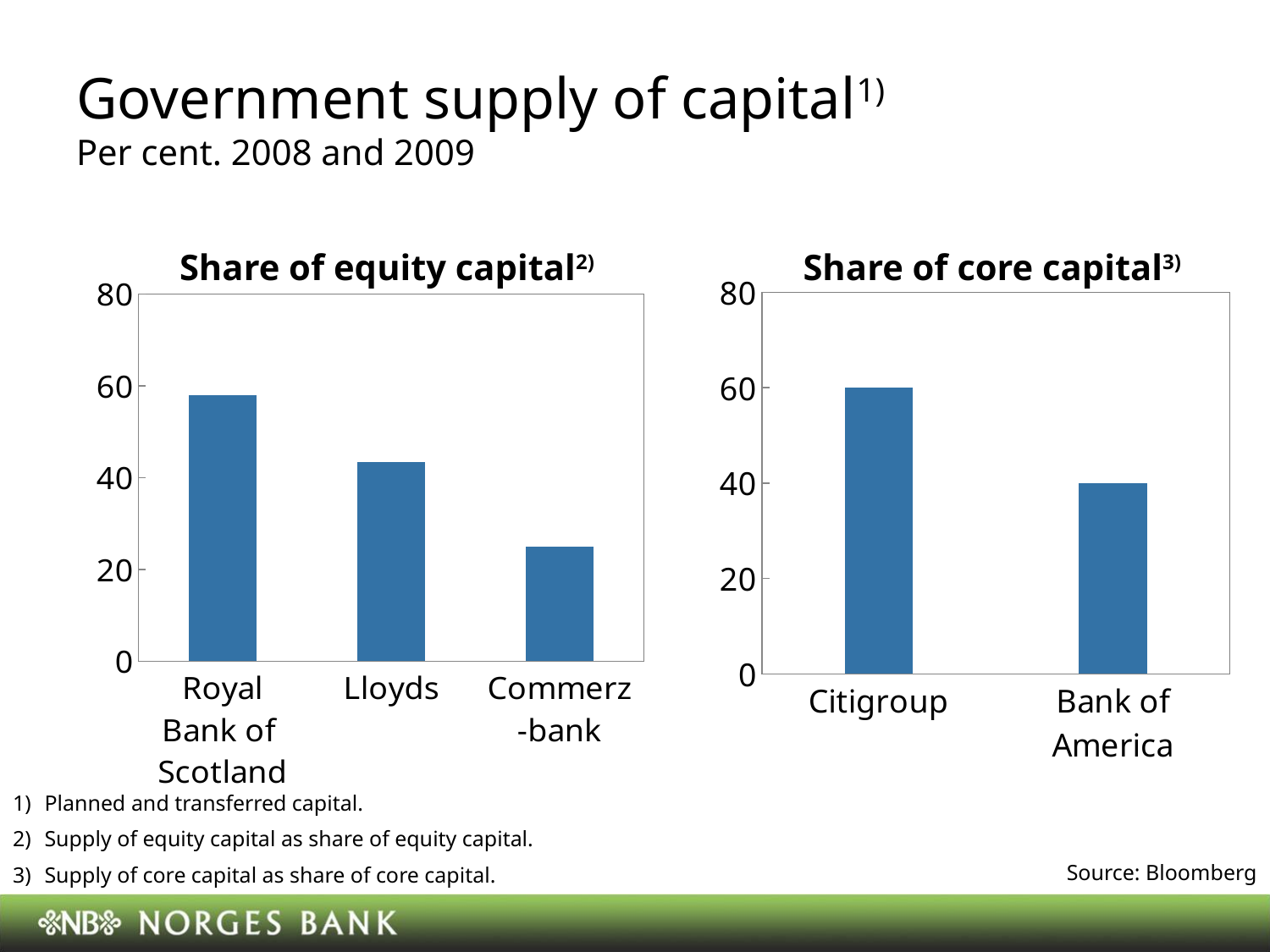
How many banks are shown in the 'Share of equity capital' chart? 3 In the 'Share of equity capital' chart, which bank has the highest value? Royal Bank of Scotland In the 'Share of equity capital' chart, is the value for Royal Bank of Scotland greater or less than 60? less In the 'Share of equity capital' chart, which bank has the lowest value? Commerzbank In the 'Share of core capital' chart, which bank has the higher value? Citigroup What type of chart is the 'Share of core capital' chart? Bar chart In the 'Share of core capital' chart, what is the value for Citigroup? 60 In the 'Share of equity capital' chart, which is larger, Lloyds or Commerzbank? Lloyds In the 'Share of core capital' chart, what is the difference between Citigroup and Bank of America? 20 In the 'Share of equity capital' chart, is the value for Lloyds greater or less than 40? greater In the 'Share of equity capital' chart, is the value for Commerzbank greater or less than 40? less In the 'Share of core capital' chart, what is the value for Bank of America? 40